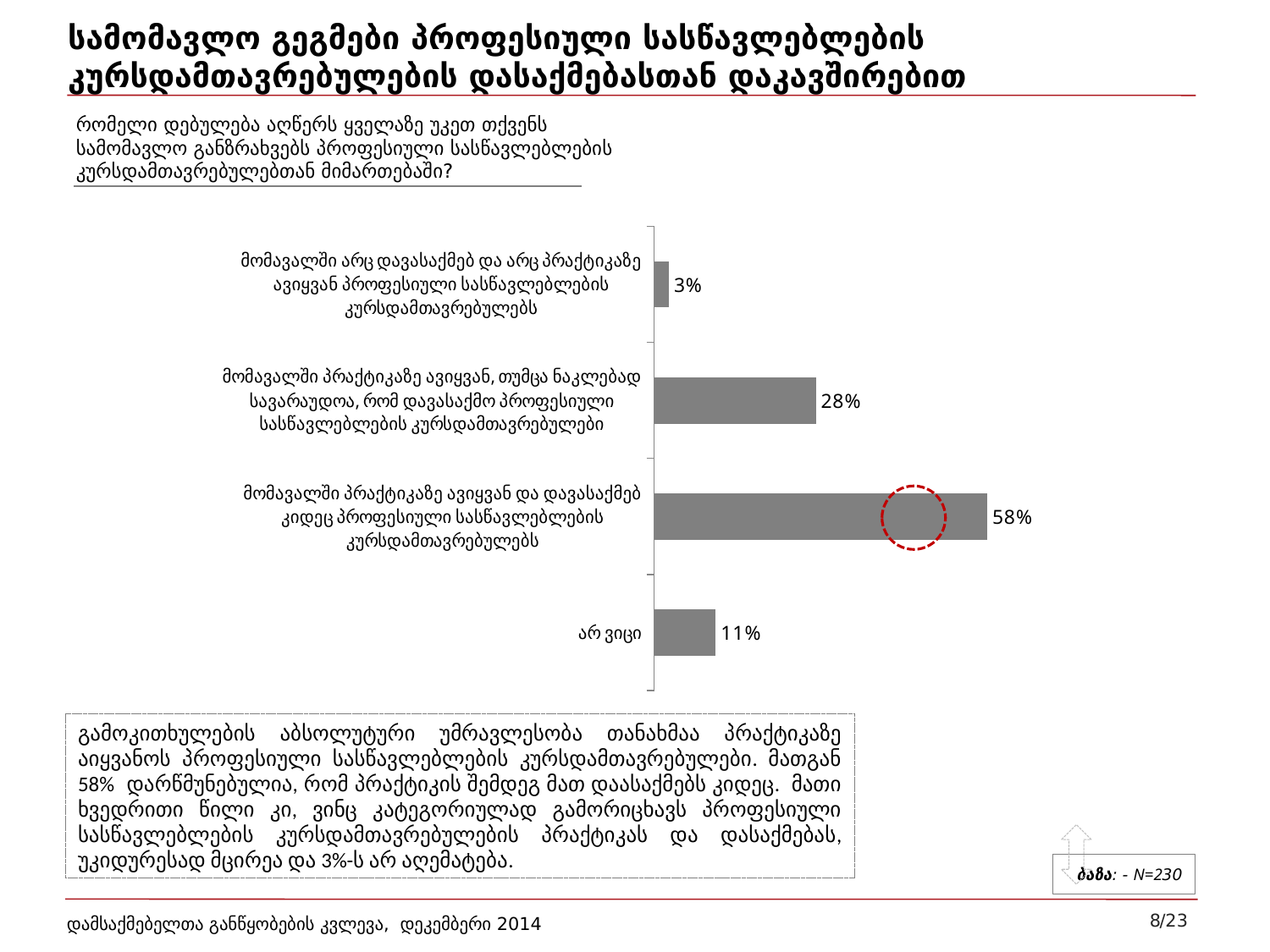
What is the value for the category "არ ვიცი"? 11% Which category has the lowest value? მომავალში არც დავასაქმებ და არც პრაქტიკაზე ავიყვან პროფესიული სასწავლებლების კურსდამთავრებულებს Which bar is circled with a red dashed line? The 58% bar How many categories are shown in the chart? 4 What is the value for the category "მომავალში არც დავასაქმებ და არც პრაქტიკაზე ავიყვან პროფესიული სასწავლებლების კურსდამთავრებულებს"? 3% What type of chart is shown on the slide? Bar chart What is the value for the category "მომავალში პრაქტიკაზე ავიყვან, თუმცა ნაკლებად სავარაუდოა, რომ დავასაქმო პროფესიული სასწავლებლების კურსდამთავრებულები"? 28% What is the value for the category "მომავალში პრაქტიკაზე ავიყვან და დავასაქმებ კიდეც პროფესიული სასწავლებლების კურსდამთავრებულებს"? 58% Which category has the highest value? მომავალში პრაქტიკაზე ავიყვან და დავასაქმებ კიდეც პროფესიული სასწავლებლების კურსდამთავრებულებს Which is larger: the value for "არ ვიცი" or the value for "მომავალში არც დავასაქმებ და არც პრაქტიკაზე ავიყვან პროფესიული სასწავლებლების კურსდამთავრებულებს"? არ ვიცი What is the difference between the highest value (58%) and the value for "არ ვიცი" (11%)? 47% What is the difference between the 28% category and the 3% category? 25%